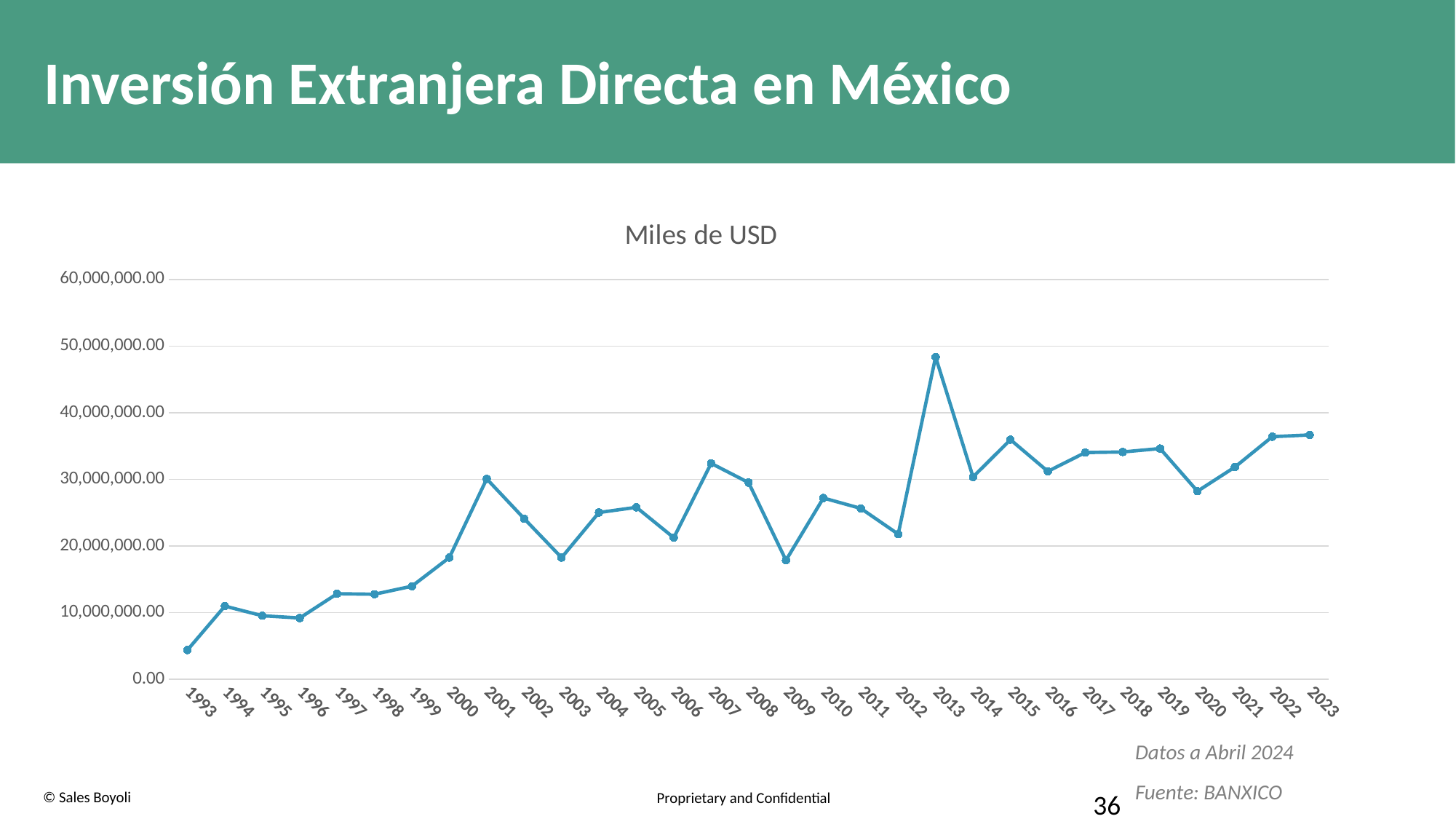
Is the value for 2009 greater or less than 20,000,000.00? less Which year has the larger value, 2013 or 2014? 2013 Which year has the highest value in the chart? 2013 Is the value for 1993 greater or less than 10,000,000.00? less Does the value rise or fall from 2013 to 2014? fall How many years are plotted on the x axis of the chart? 31 Is the value for 2022 greater or less than 30,000,000.00? greater What is the title shown above the chart? Miles de USD Which year has the lowest value in the chart? 1993 What kind of chart is shown on the slide? line chart Which year has the larger value, 2006 or 2007? 2007